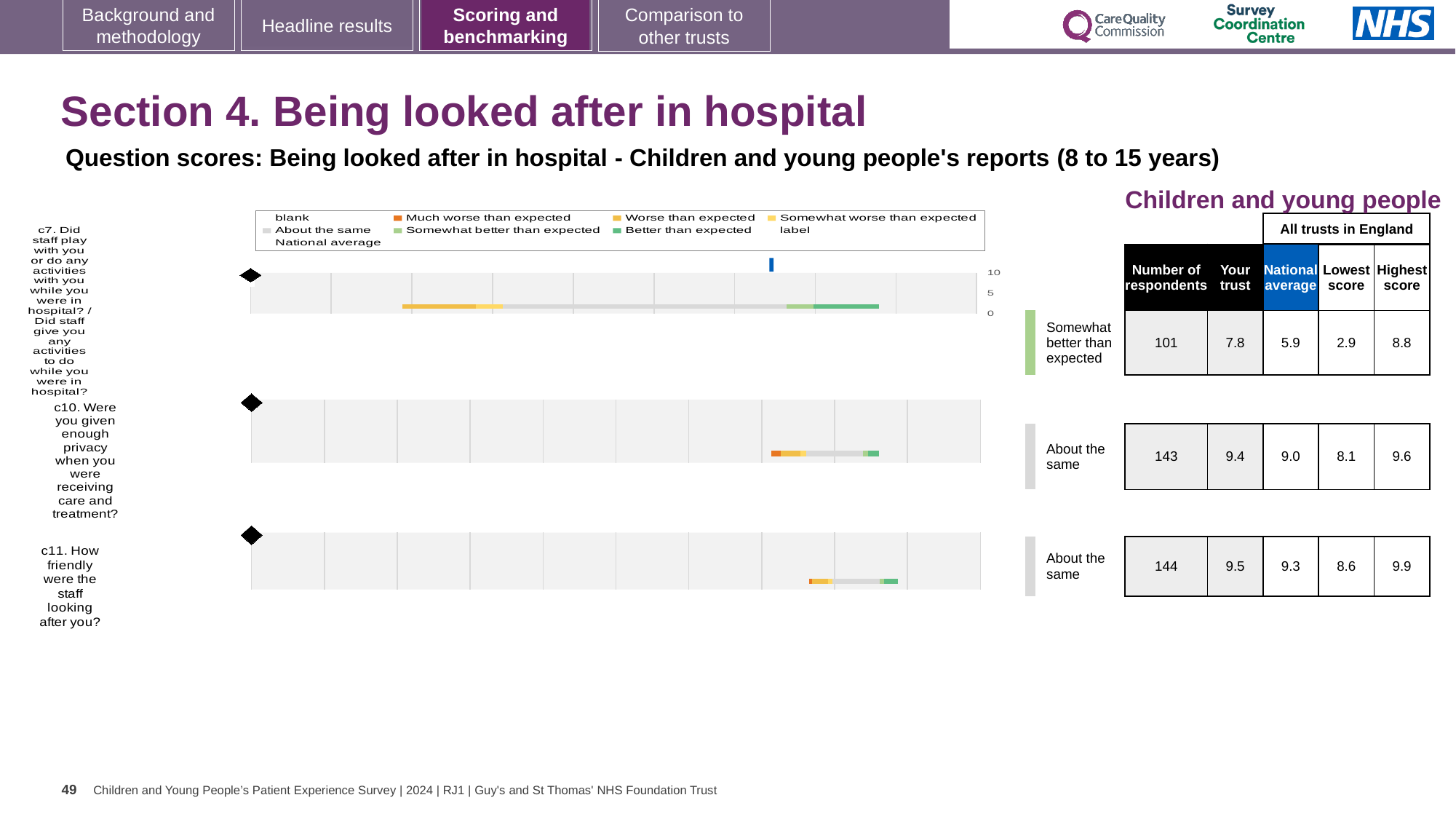
Which question has the lowest national average score? c7 What benchmark category is shown for question c7? Somewhat better than expected What is the national average score for question c10 (Were you given enough privacy when you were receiving care and treatment?)? 9.0 For question c10, which is larger: the 'Your trust' score or the national average? Your trust What is the 'Your trust' score for question c7 (Did staff play with you or do any activities with you while you were in hospital?)? 7.8 What is the highest score across all trusts in England for question c11? 9.9 Which question has the highest 'Your trust' score? c11 What type of chart is used to show the question scores on this slide? Horizontal bar chart For question c10, what is the difference between the highest score and the lowest score across all trusts in England? 1.5 How many respondents answered question c11 (How friendly were the staff looking after you?)? 144 For question c7, how much higher is the 'Your trust' score than the national average? 1.9 How many survey questions are plotted in the chart? 3